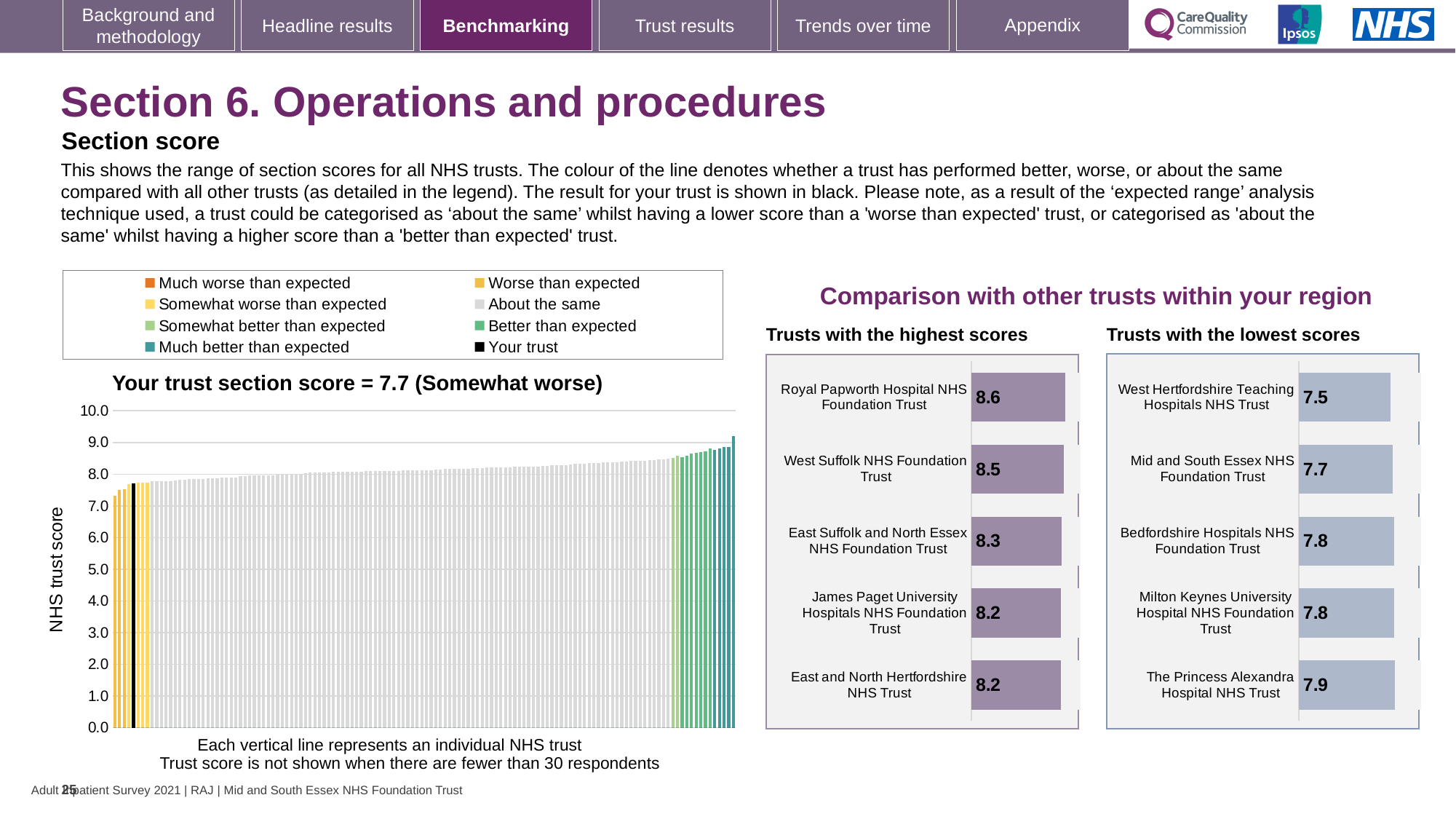
In the 'Trusts with the lowest scores' chart, what is the score for The Princess Alexandra Hospital NHS Trust? 7.9 In the 'Trusts with the highest scores' chart, what is the difference between the scores of Royal Papworth Hospital NHS Foundation Trust and East and North Hertfordshire NHS Trust? 0.4 According to the title of the chart on the left, what is your trust's section score? 7.7 In the 'Trusts with the highest scores' chart, which trust has the highest score? Royal Papworth Hospital NHS Foundation Trust In the 'Trusts with the lowest scores' chart, what is the difference between the scores of The Princess Alexandra Hospital NHS Trust and West Hertfordshire Teaching Hospitals NHS Trust? 0.4 What kind of chart is the 'Your trust section score' chart on the left of the slide? Bar chart How many entries does the legend above the 'Your trust section score' chart list? 8 In the 'Trusts with the highest scores' chart, which has the larger score: West Suffolk NHS Foundation Trust or East Suffolk and North Essex NHS Foundation Trust? West Suffolk NHS Foundation Trust In the 'Trusts with the highest scores' chart, what is the score for Royal Papworth Hospital NHS Foundation Trust? 8.6 In the 'Your trust section score' chart on the left, do the trust scores rise or fall from left to right along the x axis? Rise In the 'Trusts with the lowest scores' chart, which trust has the lowest score? West Hertfordshire Teaching Hospitals NHS Trust How many trusts are shown in the 'Trusts with the highest scores' chart? 5